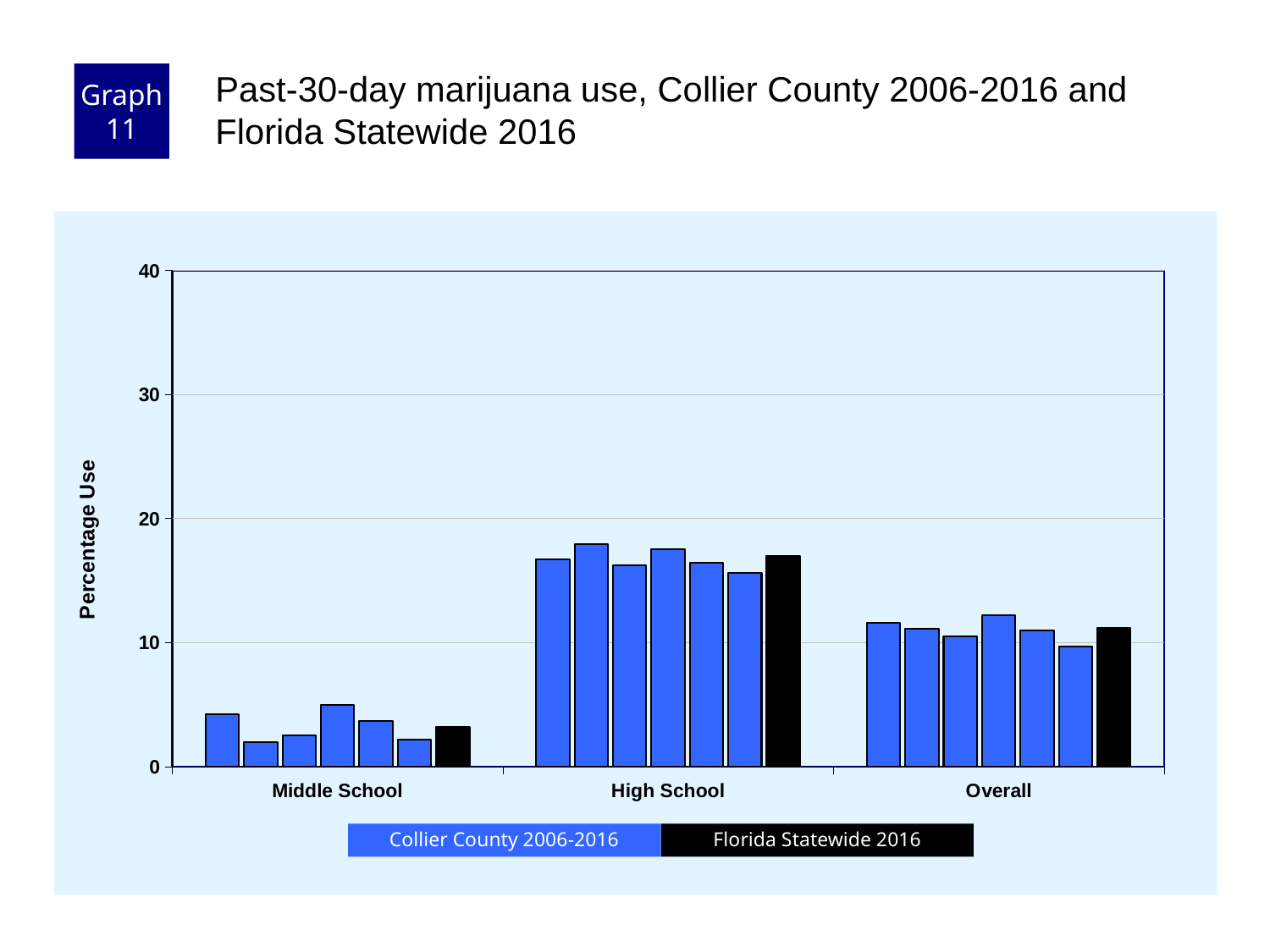
Which colour represents Florida Statewide 2016 in the legend? Black Which category has the highest Florida Statewide 2016 value? High School Which category has the lowest Florida Statewide 2016 value? Middle School Is the Florida Statewide 2016 value for Middle School greater or less than 10? less How many series does the legend list? 2 Which is larger, the Florida Statewide 2016 value for High School or for Overall? High School Is the Florida Statewide 2016 value for High School greater or less than 20? less What is the label on the y axis? Percentage Use How many categories are shown along the x axis? 3 What kind of chart is shown on the slide? Bar chart Is the Florida Statewide 2016 value for Overall greater or less than 20? less